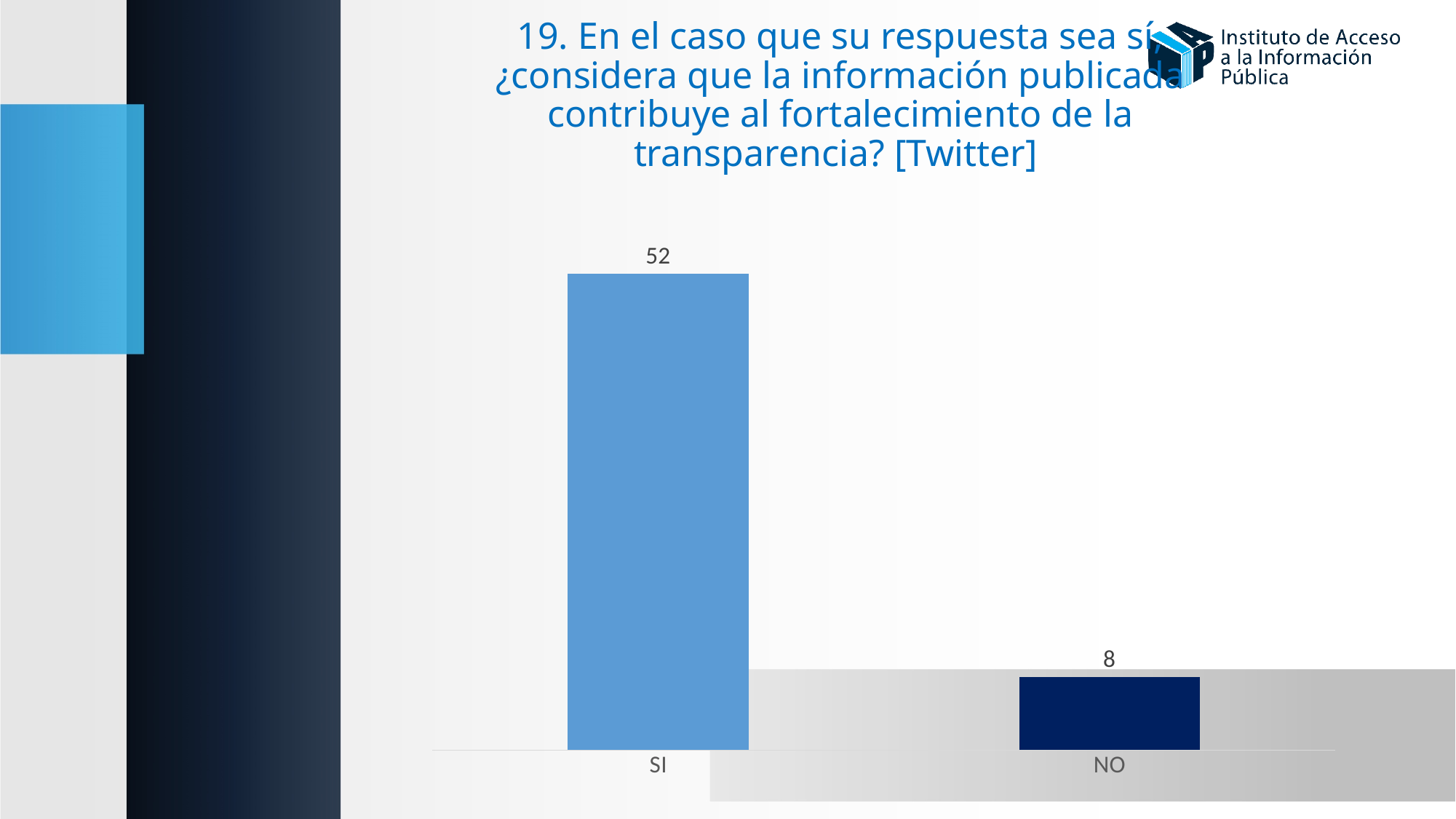
Which category has the highest value? SI What is the total of the values for SI and NO? 60 What is the difference between the values for SI and NO? 44 Which category has the lowest value? NO Which is larger, the value for SI or the value for NO? SI What kind of chart is shown on the slide? Bar chart What is the value for NO? 8 Which social network is named in the chart title? Twitter How many categories are shown in the chart? 2 What is the value for SI? 52 What colour is the bar for NO? Dark navy blue